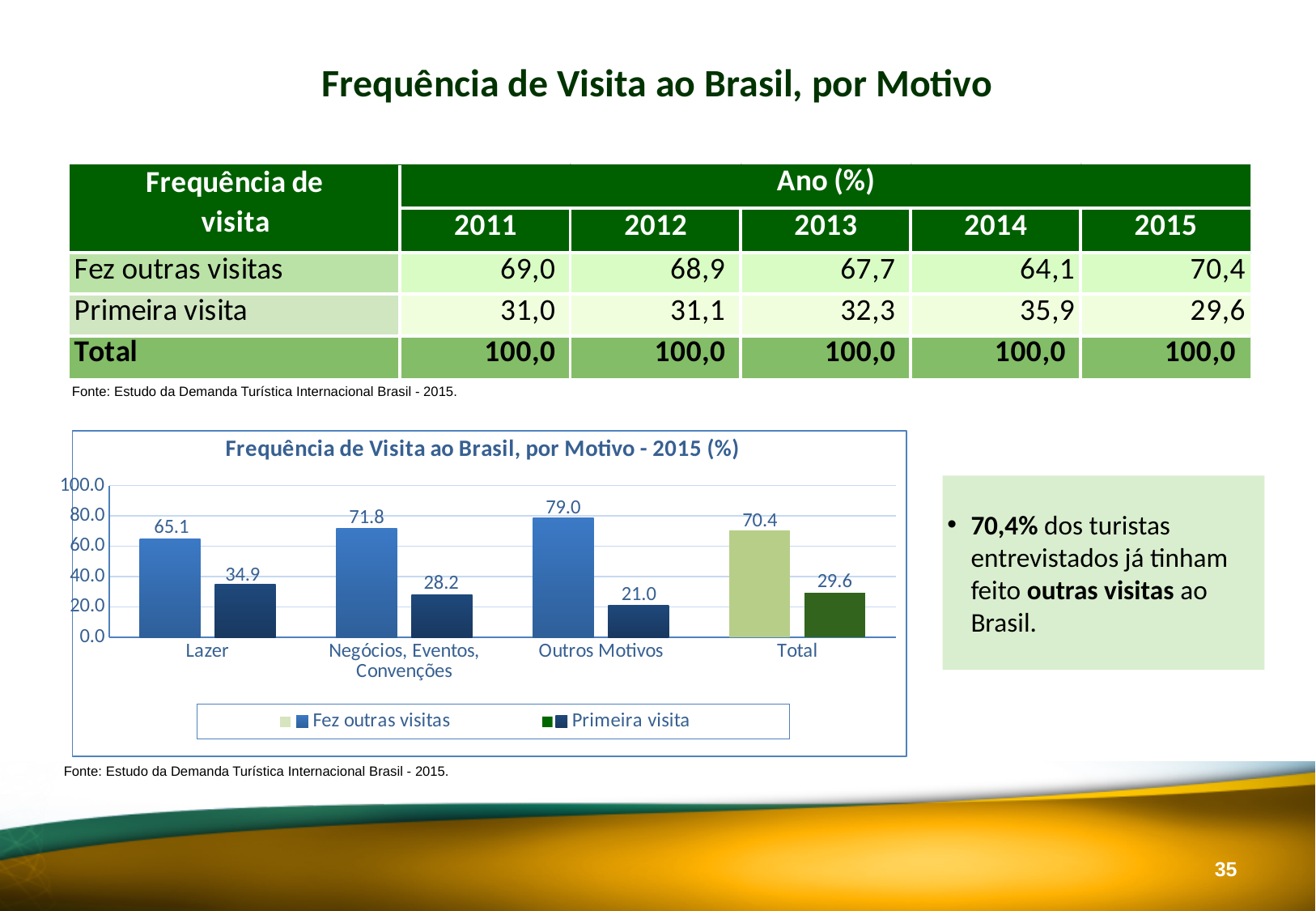
What is the value for "Primeira visita" in the Outros Motivos category? 21.0 How many categories are shown on the x axis of the chart? 4 What is the difference between "Fez outras visitas" and "Primeira visita" in the Total category? 40.8 What type of chart is shown on the slide? Bar chart What is the value for "Fez outras visitas" in the Lazer category? 65.1 Which category has the highest value for "Fez outras visitas"? Outros Motivos What is the total of "Fez outras visitas" and "Primeira visita" for the Lazer category? 100.0 What is the value for "Primeira visita" in the Negócios, Eventos, Convenções category? 28.2 Which is larger: "Primeira visita" for Lazer or "Primeira visita" for Total? Lazer Which category has the lowest value for "Primeira visita"? Outros Motivos How many series does the chart legend list? 2 What is the title of the chart? Frequência de Visita ao Brasil, por Motivo - 2015 (%)